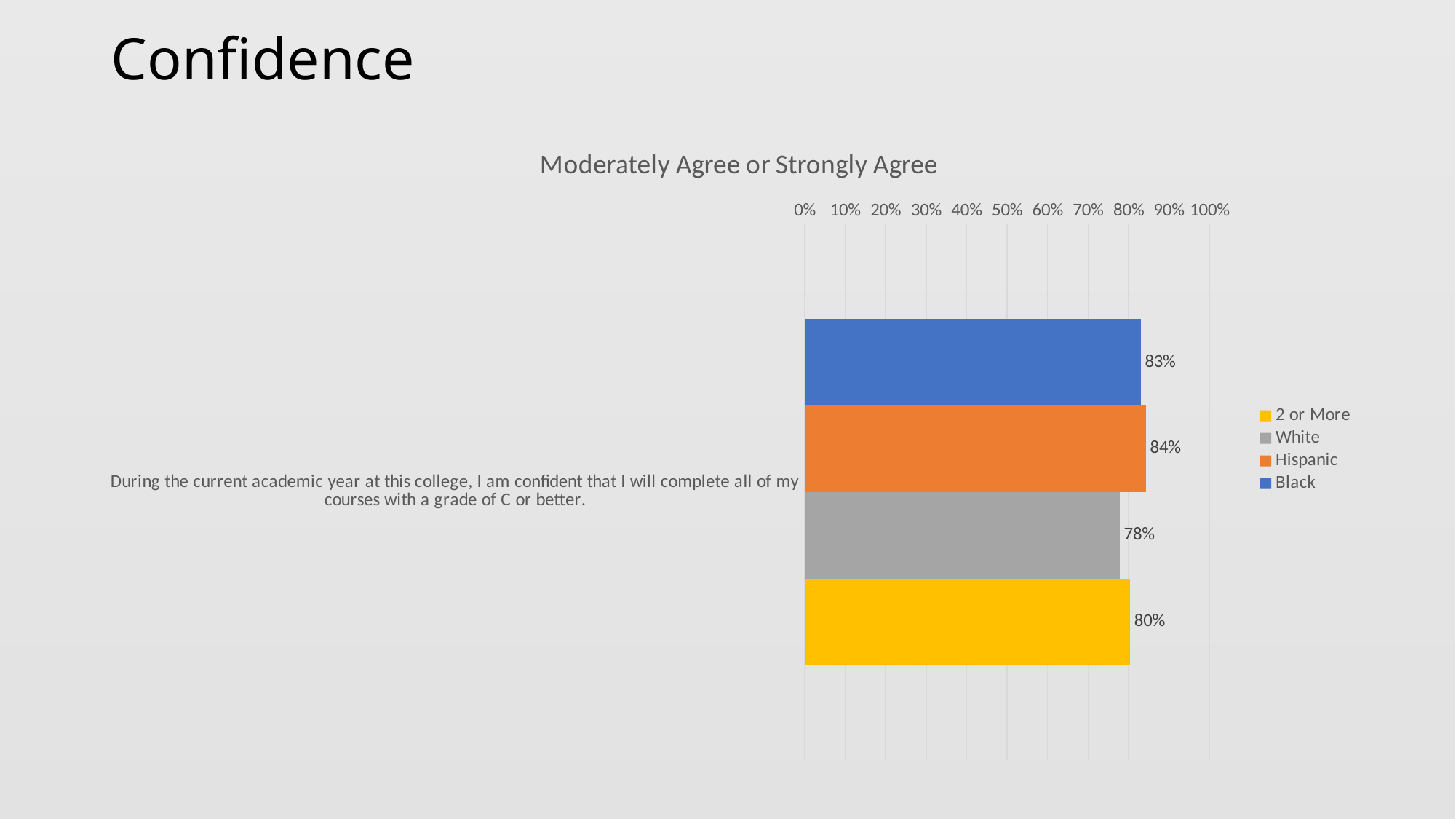
Which series has the highest value? Hispanic What is the value for Hispanic? 84% What is the value for 2 or More? 80% How many series does the legend list? 4 Which series has the lowest value? White What is the difference between the Black and 2 or More values? 3% What is the title of the chart? Moderately Agree or Strongly Agree Which is larger, the value for White or the value for 2 or More? 2 or More What kind of chart is shown on the slide? Bar chart What is the difference between the Hispanic and White values? 6% What is the value for Black? 83% What is the value for White? 78%